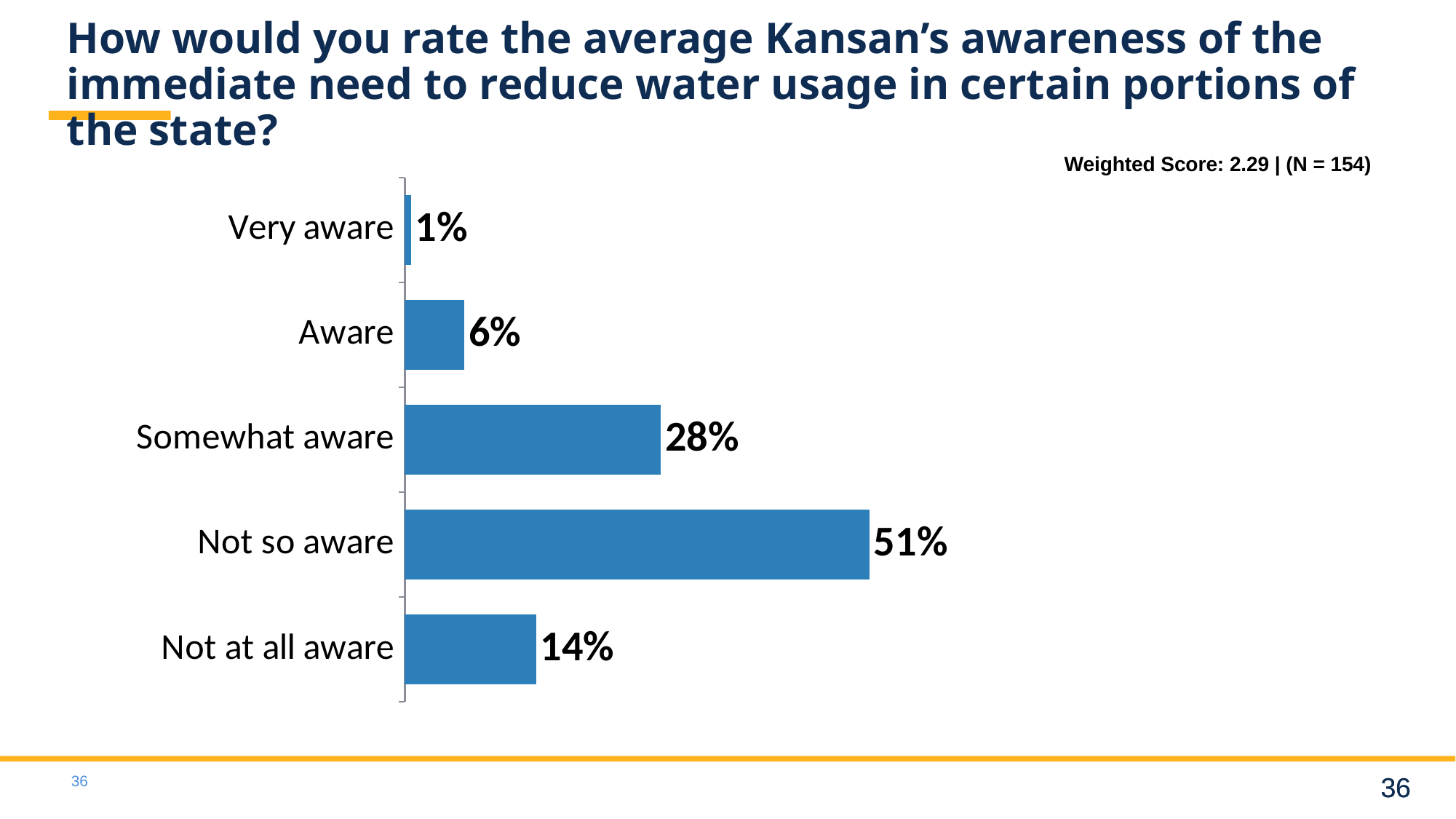
What is the difference between the values for 'Not at all aware' and 'Aware'? 8% What weighted score is shown on the slide? 2.29 Which category has the lowest value? Very aware What is the value for 'Not at all aware'? 14% What percentage of respondents rated the average Kansan as 'Not so aware'? 51% Which category has the highest value? Not so aware Which is larger, the value for 'Aware' or the value for 'Not at all aware'? Not at all aware What is the difference between the values for 'Not so aware' and 'Somewhat aware'? 23% What is the value for 'Very aware'? 1% What is the value for 'Somewhat aware'? 28% What kind of chart is shown on the slide? Bar chart How many categories are shown in the chart? 5